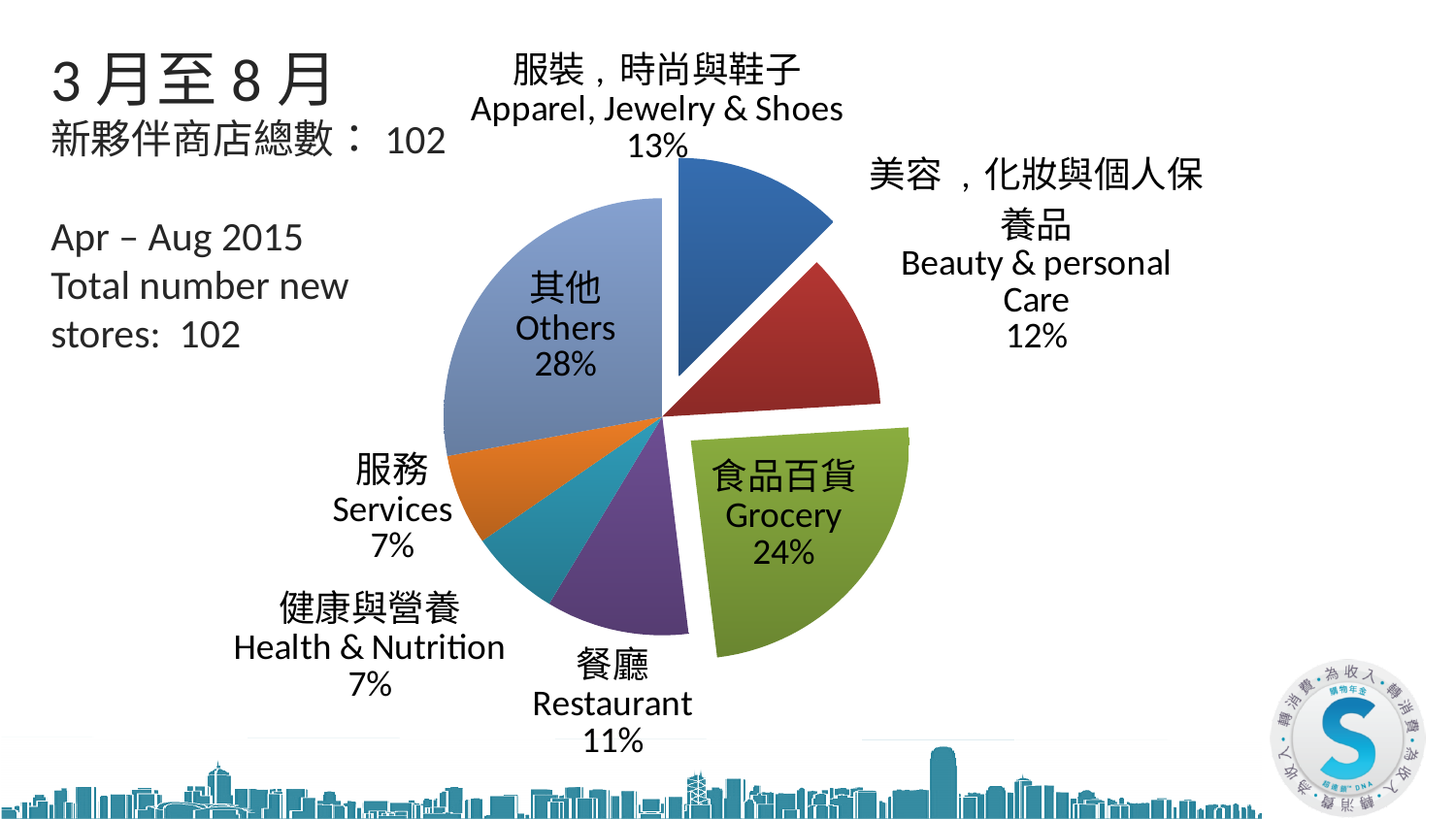
What is the difference in percentage points between Others and Grocery? 4 Which category has the largest share of the pie? Others How many slices does the pie chart have? 7 What percentage is shown for Restaurant? 11% Which category has the smallest share, Grocery or Restaurant? Restaurant What share does Beauty & personal Care have? 12% What share of new stores is Grocery? 24% Which is larger, Apparel, Jewelry & Shoes or Beauty & personal Care? Apparel, Jewelry & Shoes What period does the chart cover? Apr – Aug 2015 What kind of chart is shown on the slide? pie chart What is the total number of new stores stated on the slide? 102 What percentage of the pie is Apparel, Jewelry & Shoes? 13%